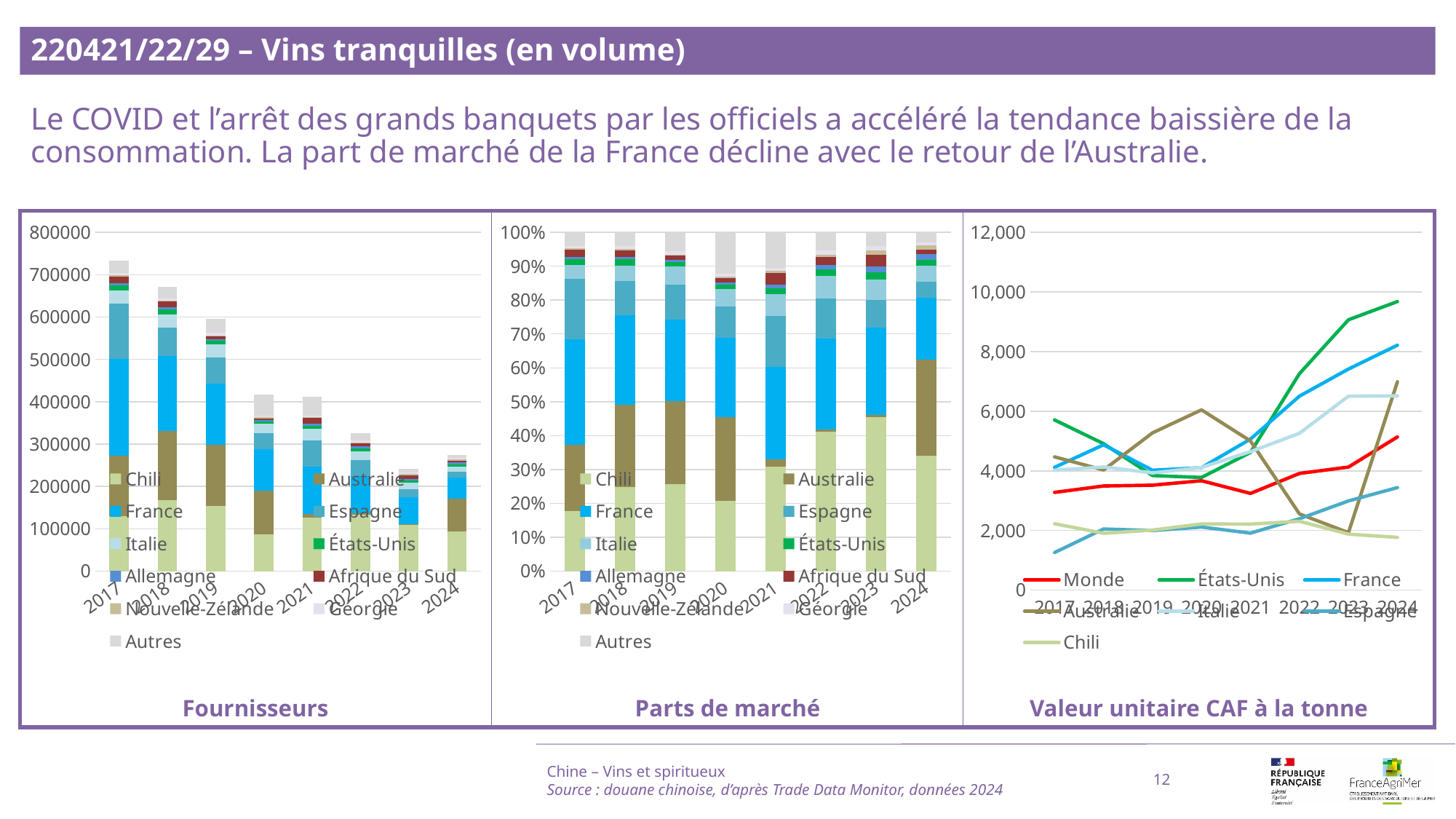
In the 'Fournisseurs' chart, which year has the lowest total bar? 2023 In the 'Fournisseurs' chart, do the total bars generally rise or fall from 2017 to 2024? fall How many series does the legend of the 'Parts de marché' chart list? 11 In the 'Valeur unitaire CAF à la tonne' chart, which series has the highest value in 2024? États-Unis In the 'Valeur unitaire CAF à la tonne' chart, which is larger in 2024, France or Monde? France In the 'Valeur unitaire CAF à la tonne' chart, is the value for États-Unis in 2024 greater or less than 8,000? greater In the 'Fournisseurs' chart, which year has the highest total bar? 2017 In the 'Fournisseurs' chart, is the total for 2017 greater or less than 700000? greater What kind of chart is the 'Valeur unitaire CAF à la tonne' chart? line chart How many series does the legend of the 'Valeur unitaire CAF à la tonne' chart list? 7 What kind of chart is the 'Fournisseurs' chart? stacked bar chart How many years are shown on the x axis of the 'Fournisseurs' chart? 8